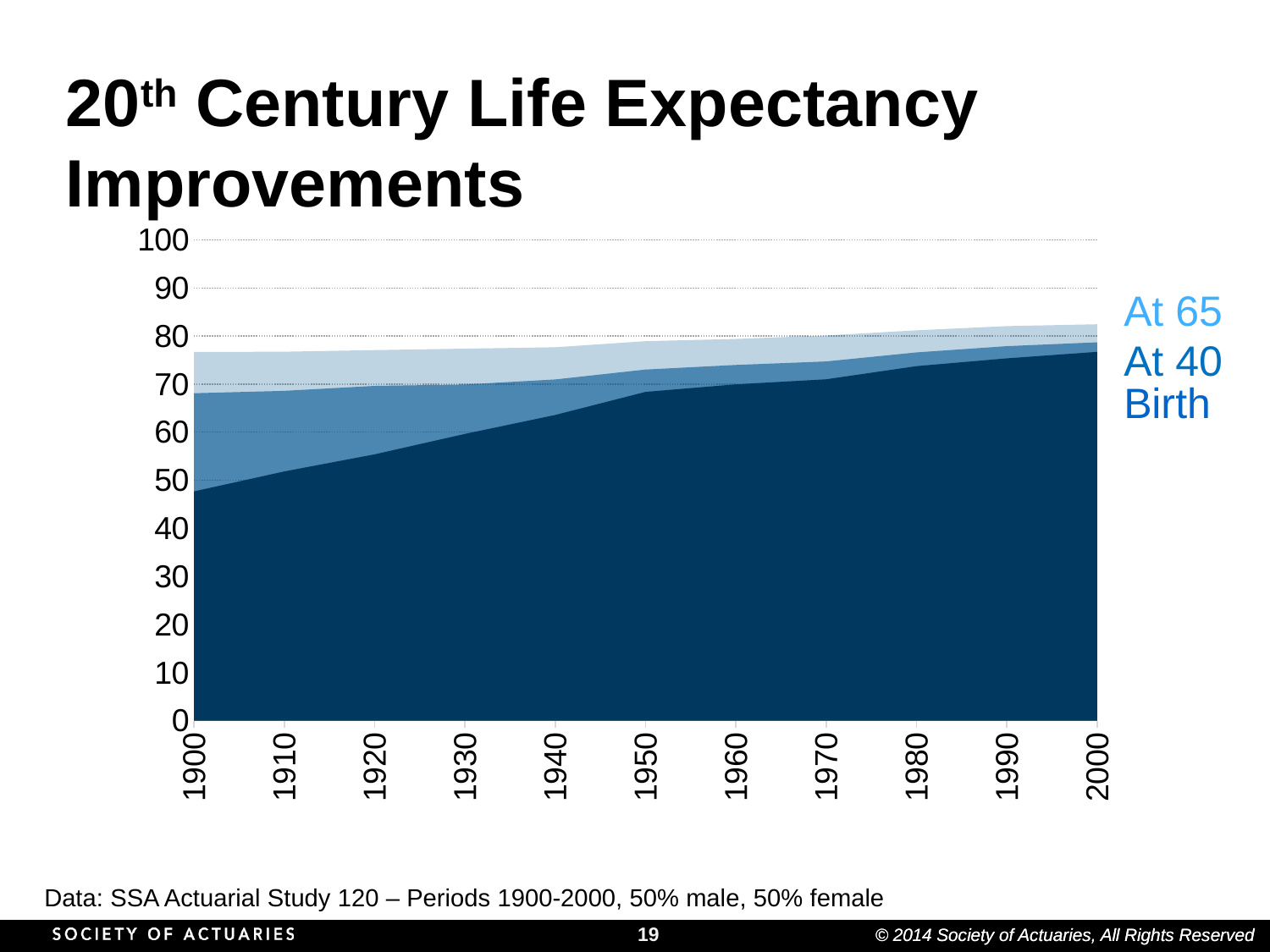
How many series does the legend list? 3 What kind of chart is shown on the slide? Area chart Is the value of the Birth series in 1920 greater or less than 50? greater Does the Birth series rise or fall from 1900 to 2000? Rises Is the value of the Birth series in 1900 greater or less than 60? less Is the value of the Birth series in 1940 greater or less than 70? less How many years are labelled along the x axis? 11 Which year shows the highest value for the Birth series? 2000 What is the title of the chart on the slide? 20th Century Life Expectancy Improvements What are the three series named in the legend? At 65, At 40, Birth